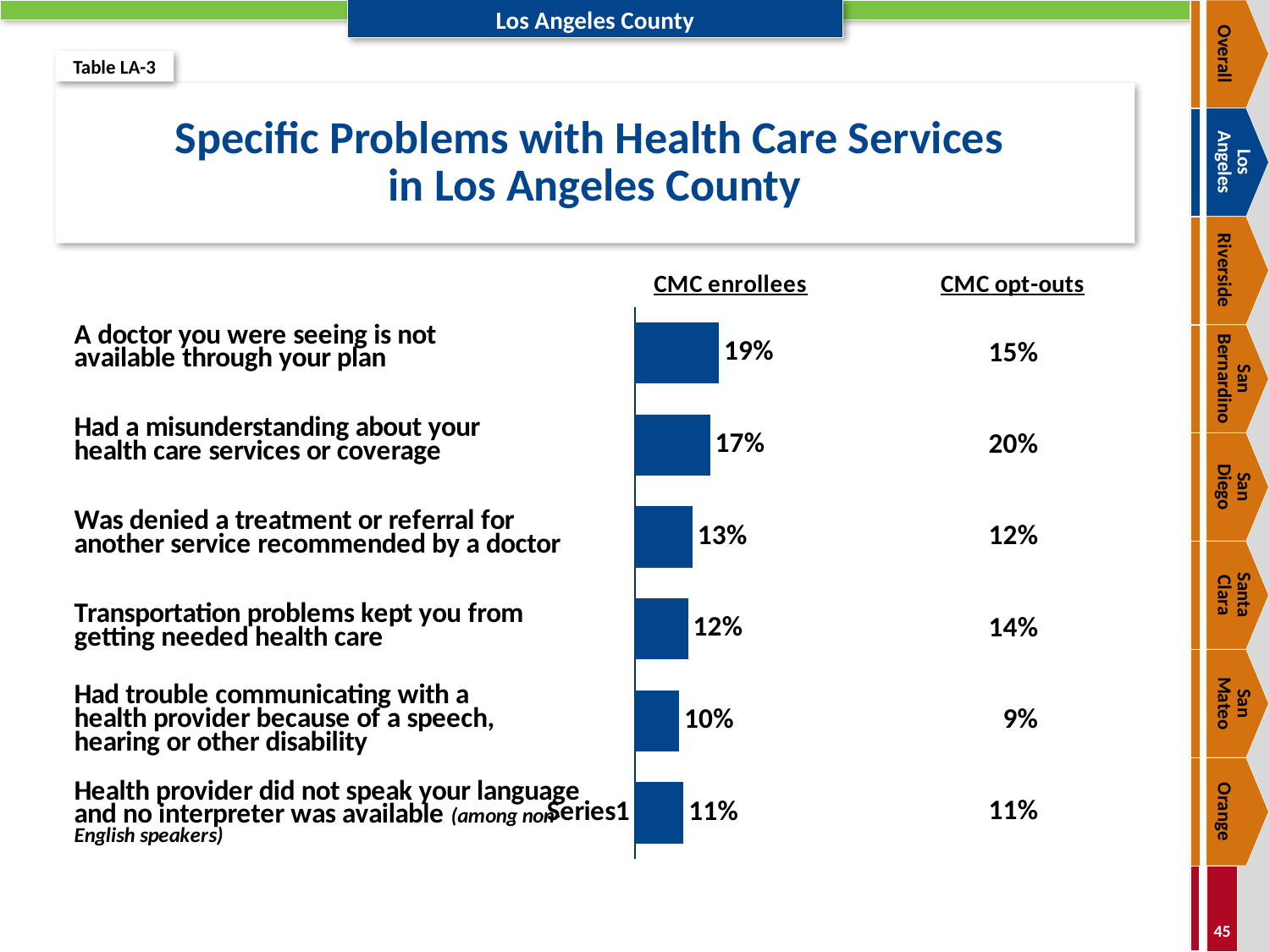
What is the CMC enrollees value for 'Had a misunderstanding about your health care services or coverage'? 17% For 'Had a misunderstanding about your health care services or coverage', which group has the larger value: CMC enrollees or CMC opt-outs? CMC opt-outs What is the CMC enrollees value for 'A doctor you were seeing is not available through your plan'? 19% What type of chart is shown on the slide? bar chart How many problem categories are plotted as bars in the chart? 6 Which problem has the lowest CMC enrollees value? Had trouble communicating with a health provider because of a speech, hearing or other disability Which problem has the highest CMC enrollees value? A doctor you were seeing is not available through your plan What is the CMC enrollees value for 'Health provider did not speak your language and no interpreter was available'? 11% Among CMC enrollees, which is larger: 'Was denied a treatment or referral for another service recommended by a doctor' or 'Transportation problems kept you from getting needed health care'? Was denied a treatment or referral for another service recommended by a doctor What is the difference between the CMC enrollees values for 'A doctor you were seeing is not available through your plan' and 'Had a misunderstanding about your health care services or coverage'? 2 percentage points What is the CMC enrollees value for 'Transportation problems kept you from getting needed health care'? 12% What is the title of the chart? Specific Problems with Health Care Services in Los Angeles County